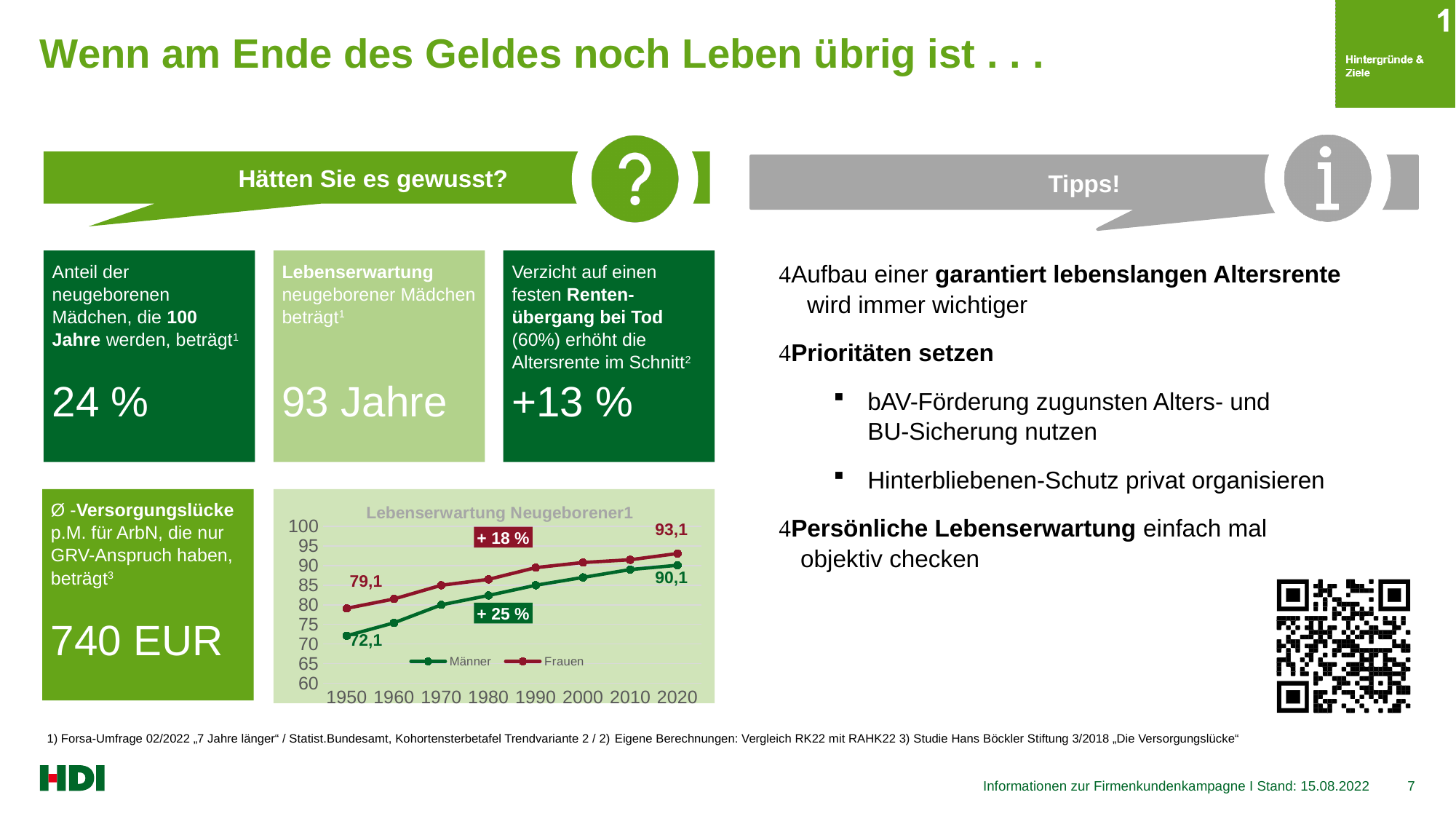
What is the title of the chart? Lebenserwartung Neugeborener1 What is the value for Frauen in 1950? 79,1 What is the value for Männer in 1950? 72,1 What is the value for Männer in 2020? 90,1 Is the value for Männer in 1980 greater or less than 85? less Which series has the higher value in 2020, Männer or Frauen? Frauen How many years are shown on the x axis of the chart? 8 What is the value for Frauen in 2020? 93,1 What is the difference between the Frauen and Männer values in 2020? 3,0 How many series does the legend of the chart list? 2 What kind of chart is shown on the slide? line chart Do the values for Männer rise or fall from 1950 to 2020? rise